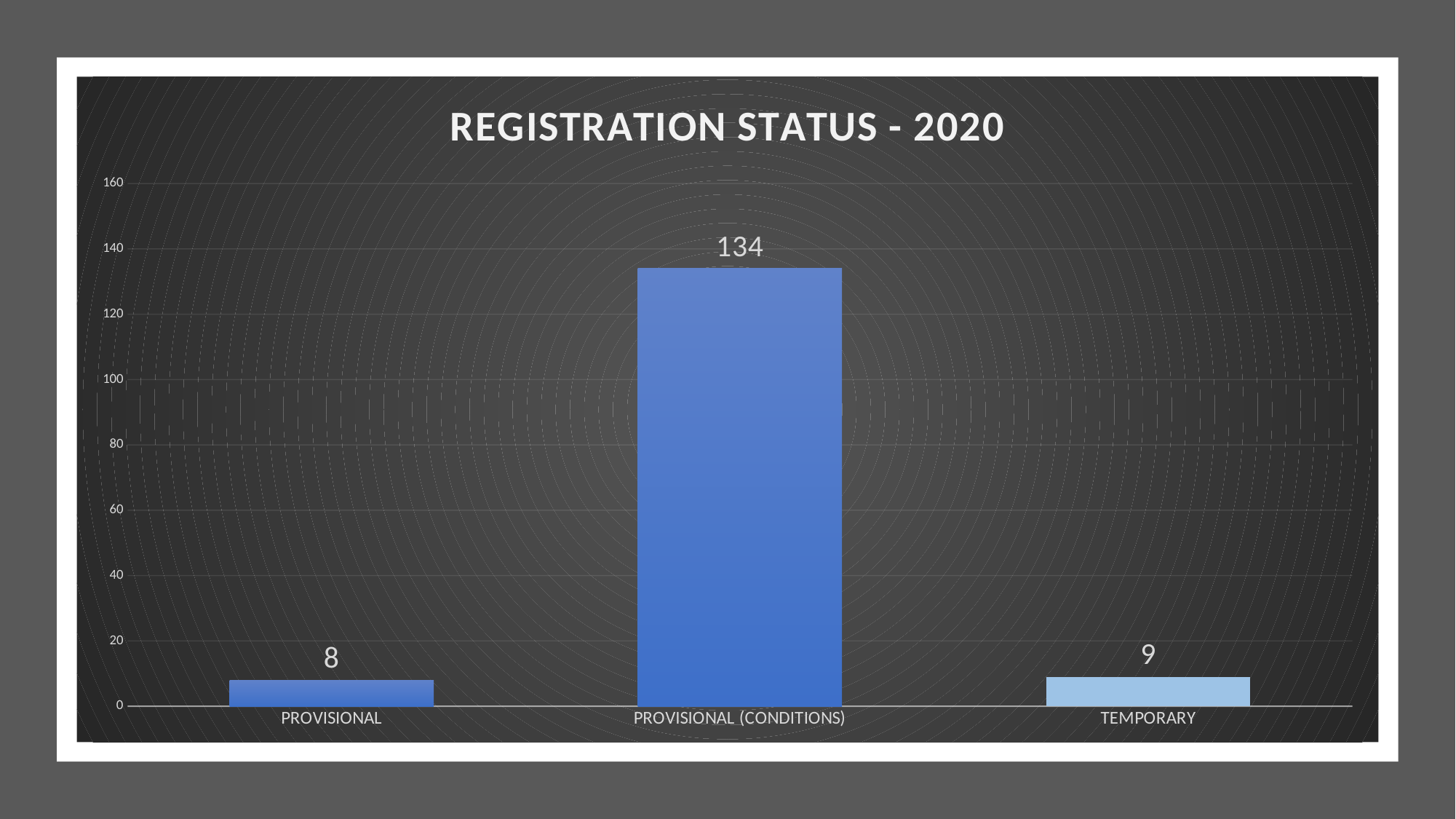
How many categories are shown on the x axis? 3 What is the value for TEMPORARY? 9 What is the difference between the values for TEMPORARY and PROVISIONAL? 1 What is the title of the chart? REGISTRATION STATUS - 2020 Which category has the lowest value? PROVISIONAL What is the value for PROVISIONAL (CONDITIONS)? 134 Which is larger, the value for TEMPORARY or the value for PROVISIONAL? TEMPORARY What kind of chart is shown on the slide? bar chart Which category has the highest value? PROVISIONAL (CONDITIONS) What is the difference between the values for PROVISIONAL (CONDITIONS) and TEMPORARY? 125 Is the value for PROVISIONAL (CONDITIONS) greater or less than 120? greater What is the value for PROVISIONAL? 8